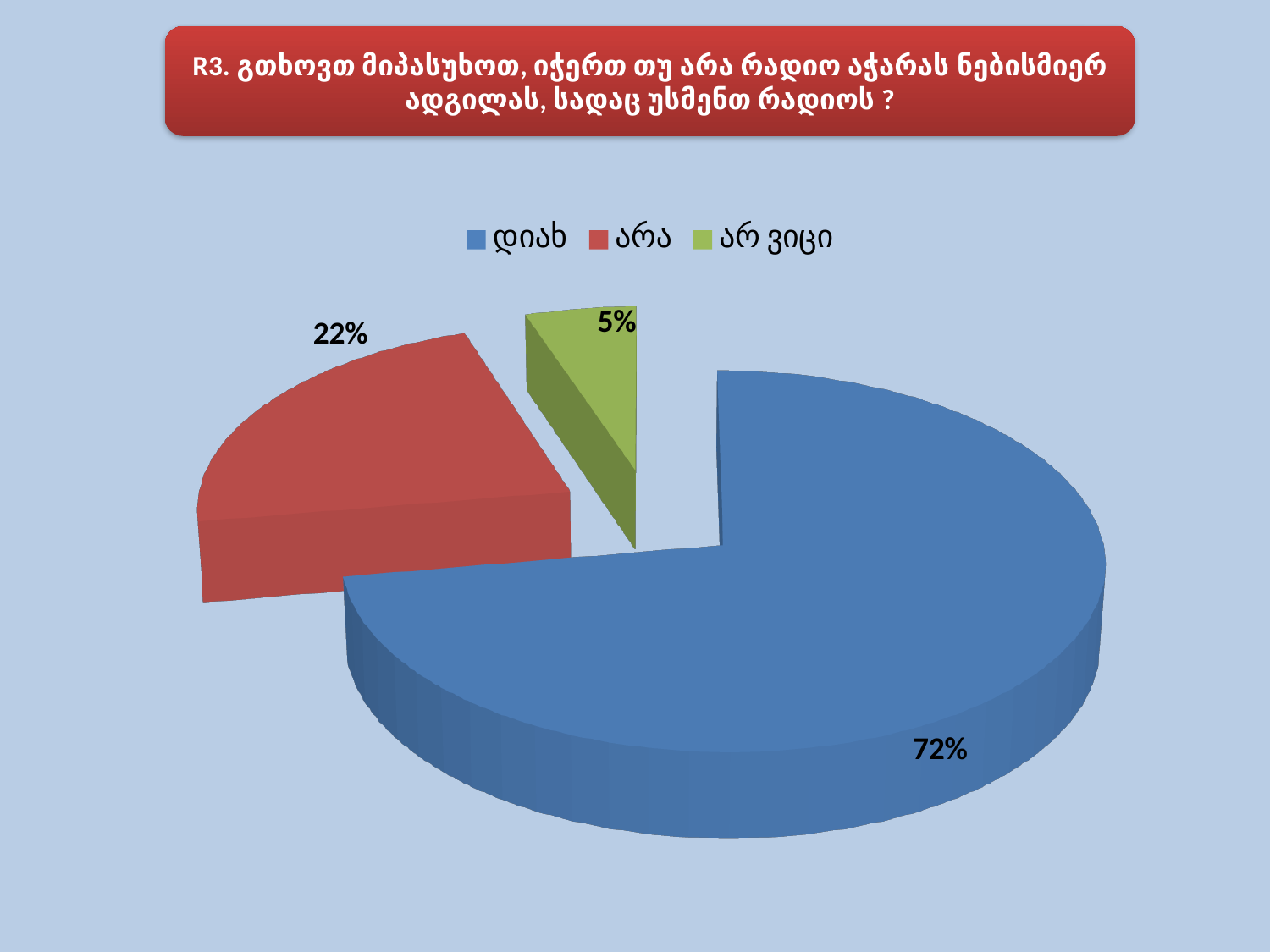
What colour is the "დიახ" slice in the pie chart? blue Which category has the largest slice of the pie? დიახ What share of the pie does the "არ ვიცი" slice represent? 5% How many slices does the pie chart have? 3 How many entries does the legend list? 3 Which is larger, the "არა" slice or the "არ ვიცი" slice? არა What is the difference in percentage points between the "არა" and "არ ვიცი" slices? 17 Which category has the smallest slice of the pie? არ ვიცი What share of the pie does the "არა" slice represent? 22% What type of chart is shown on the slide? pie chart What share of the pie does the "დიახ" slice represent? 72% What is the difference in percentage points between the "დიახ" and "არა" slices? 50